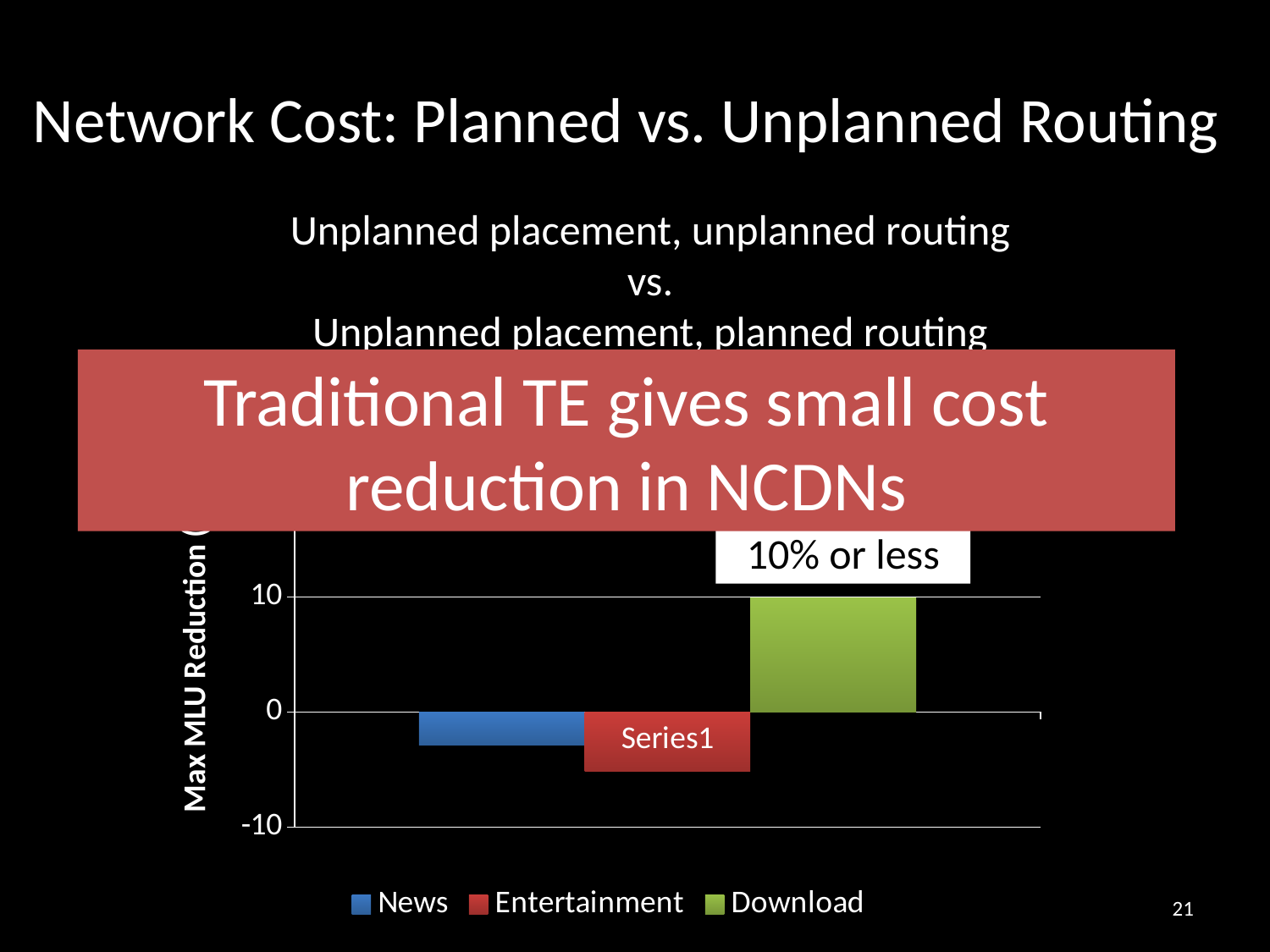
Is the value for News greater or less than 0? less What kind of chart is shown on the slide? bar chart How many series does the chart legend list? 3 Is the value for Entertainment greater or less than 0? less Which series has the highest value in the chart? Download Is the value for Entertainment greater or less than -10? greater What colour is the Download series in the chart? green What are the three entries in the chart legend? News, Entertainment, Download Which is larger, the value for News or the value for Entertainment? News Which series has the lowest value in the chart? Entertainment